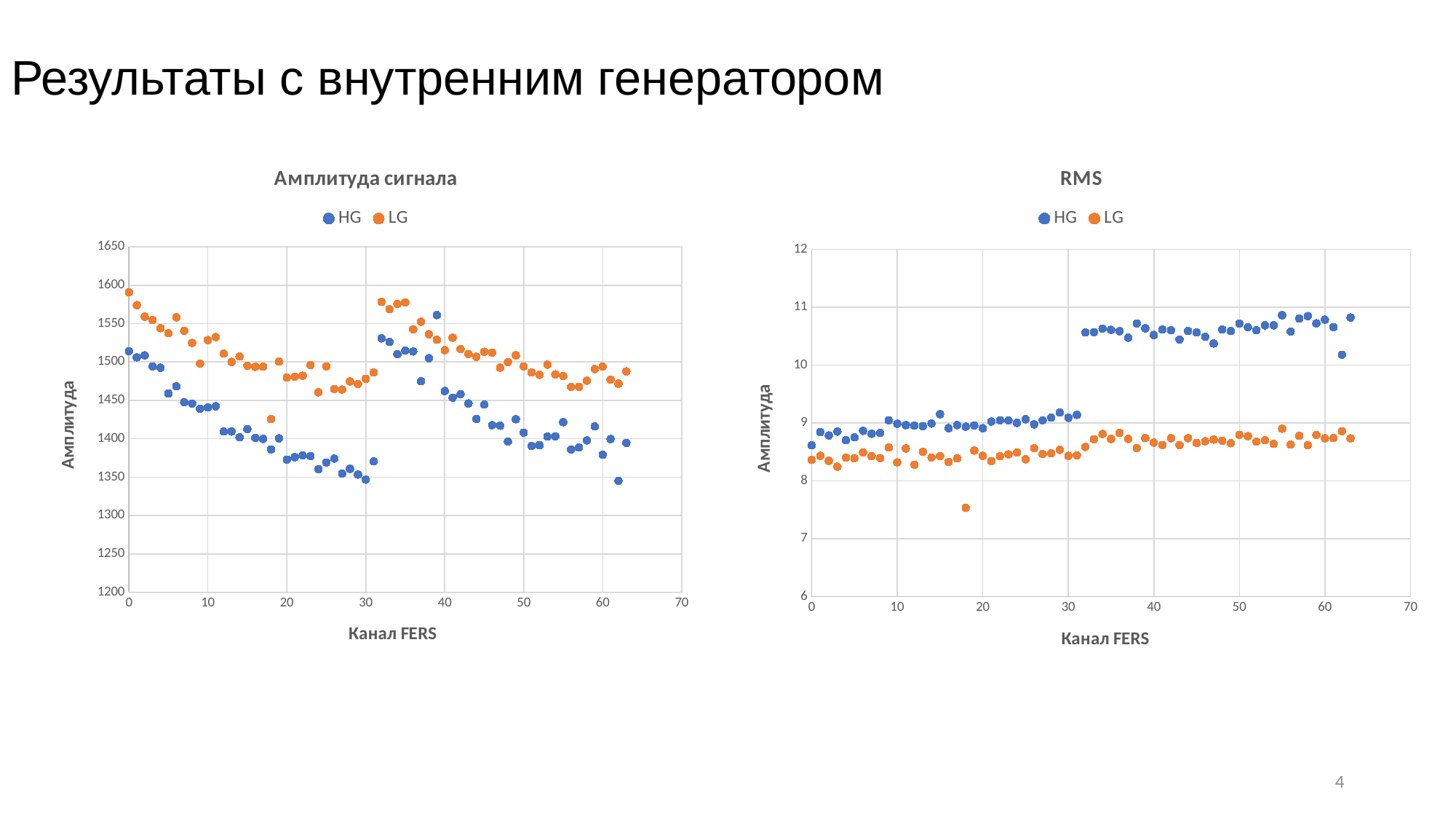
What are the two series named in the legend of the "Амплитуда сигнала" chart? HG and LG In the "Амплитуда сигнала" chart, do the HG values rise or fall from channel 0 to channel 30? fall What is the x-axis label of the "RMS" chart? Канал FERS In the "Амплитуда сигнала" chart, which series has the larger value at channel 0, HG or LG? LG What kind of chart is the "Амплитуда сигнала" chart on the left? scatter chart In the "Амплитуда сигнала" chart, is the LG value at channel 0 greater or less than 1550? greater In the "RMS" chart, is the HG value at channel 40 greater or less than 10? greater How many series does the legend of the "RMS" chart list? 2 In the "RMS" chart, is the LG value at channel 18 greater or less than 8? less In the "RMS" chart, which series has the larger value at channel 50, HG or LG? HG In the "RMS" chart, do the HG values rise or fall when going from channel 30 to channel 35? rise